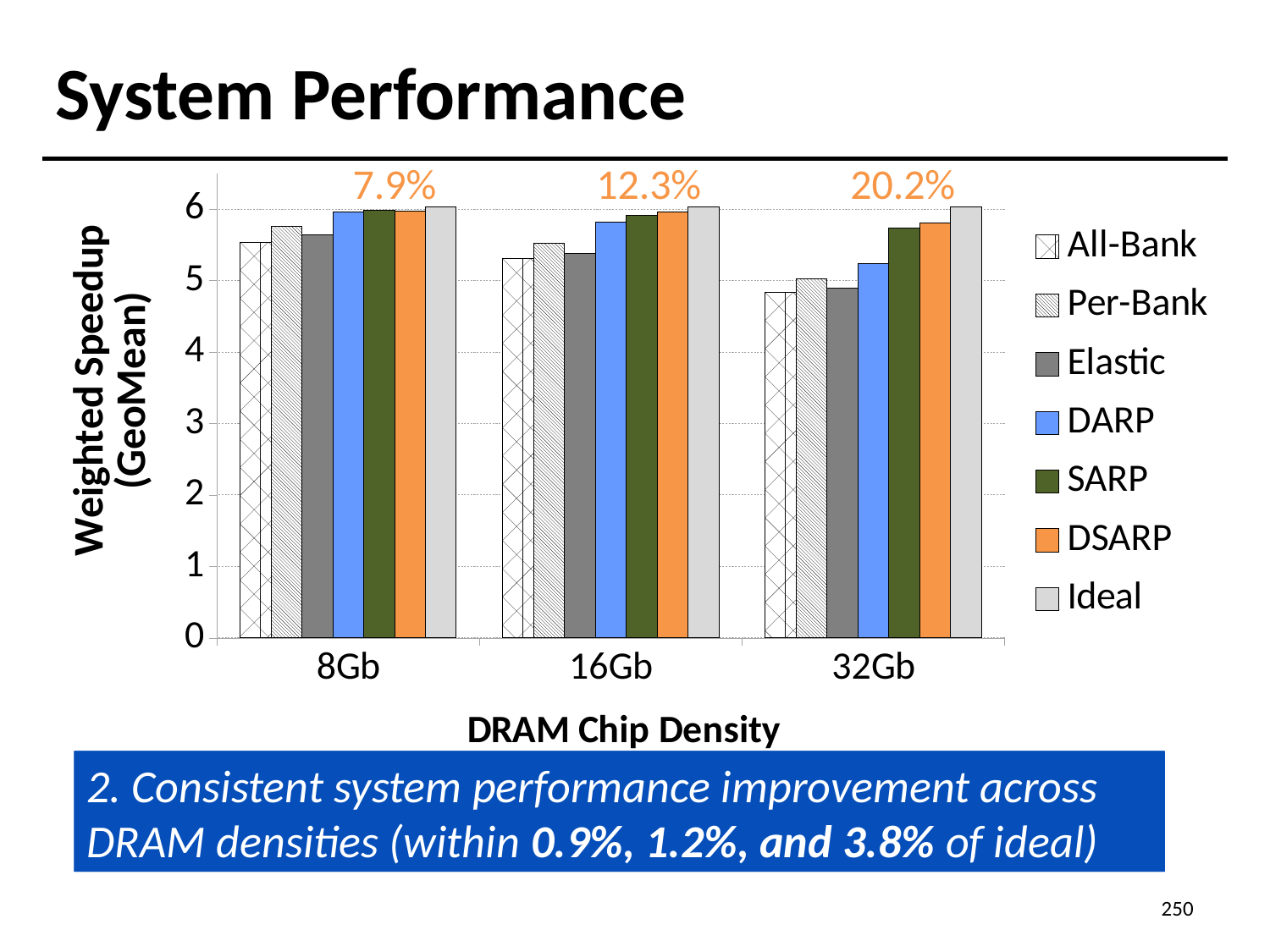
What is the title of the y axis? Weighted Speedup (GeoMean) At 32Gb, which is larger, the value for DARP or the value for Elastic? DARP How many DRAM chip density categories are shown on the x axis? 3 What percentage is printed above the 32Gb group of bars? 20.2% At 16Gb, which is larger, the value for SARP or the value for Per-Bank? SARP Is the value for Elastic at 16Gb greater or less than 5? greater Is the value for All-Bank at 32Gb greater or less than 5? less Which series has the highest value in the 32Gb group? Ideal Do the All-Bank values rise or fall as DRAM chip density increases from 8Gb to 32Gb? fall Is the value for DARP at 8Gb greater or less than 5? greater What kind of chart is shown on the slide? bar chart How many series does the legend list? 7